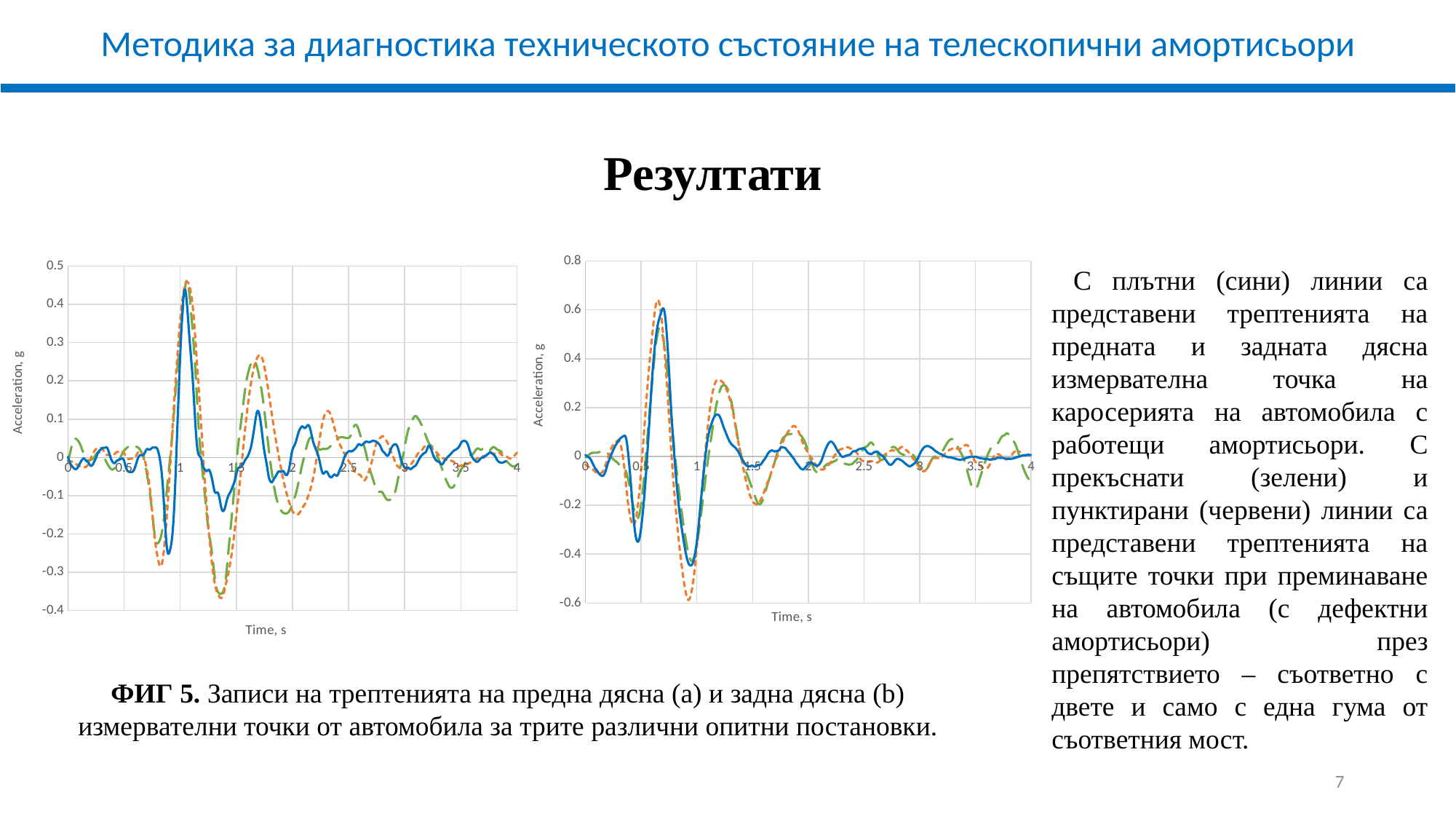
In the right chart, is the highest peak of the solid blue line greater or less than 0.4? greater In the left chart, is the highest peak of the solid blue line greater or less than 0.3? greater How many lines are plotted in the left chart? 3 In the right chart, is the lowest point of the dotted orange line greater or less than -0.4? less What kind of chart is the right chart (b)? line chart How many lines are plotted in the right chart? 3 What is the label of the horizontal axis on the right chart? Time, s What kind of chart is the left chart (a)? line chart What is the label of the vertical axis on the left chart? Acceleration, g